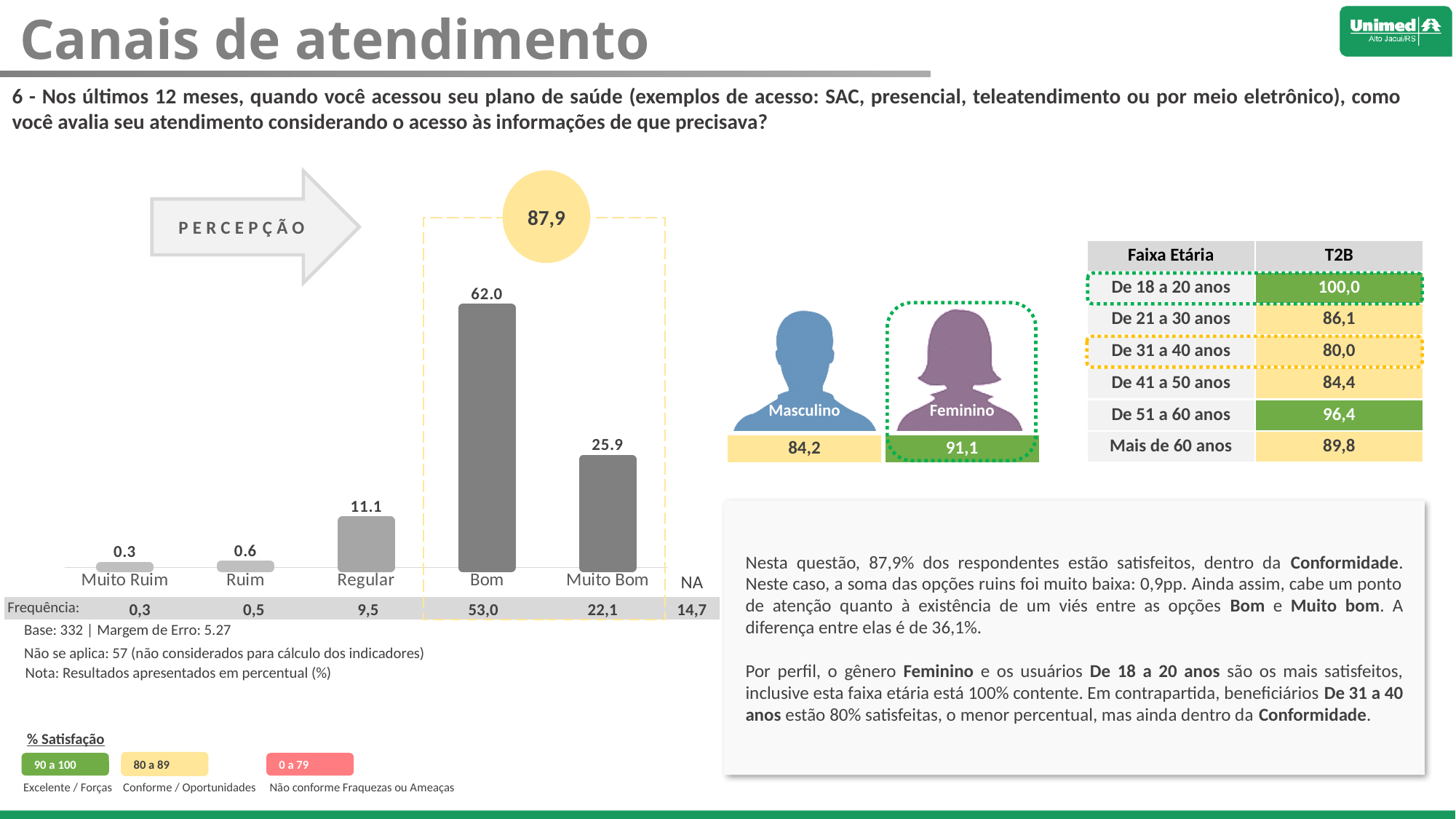
Which bar is larger, Regular or Muito Bom? Muito Bom What is the value of the Bom bar in the chart? 62.0 What is the value of the Muito Bom bar in the chart? 25.9 How many bars are plotted in the chart? 5 What is the value of the Regular bar in the chart? 11.1 What kind of chart is shown on the slide? bar chart What value is shown in the yellow circle above the dashed box around Bom and Muito Bom? 87,9 What is the difference between the Bom and Muito Bom bars? 36.1 Which category has the lowest bar in the chart? Muito Ruim Which category has the highest bar in the chart? Bom What is the difference between the Regular and Ruim bars? 10.5 What is the value of the Muito Ruim bar in the chart? 0.3